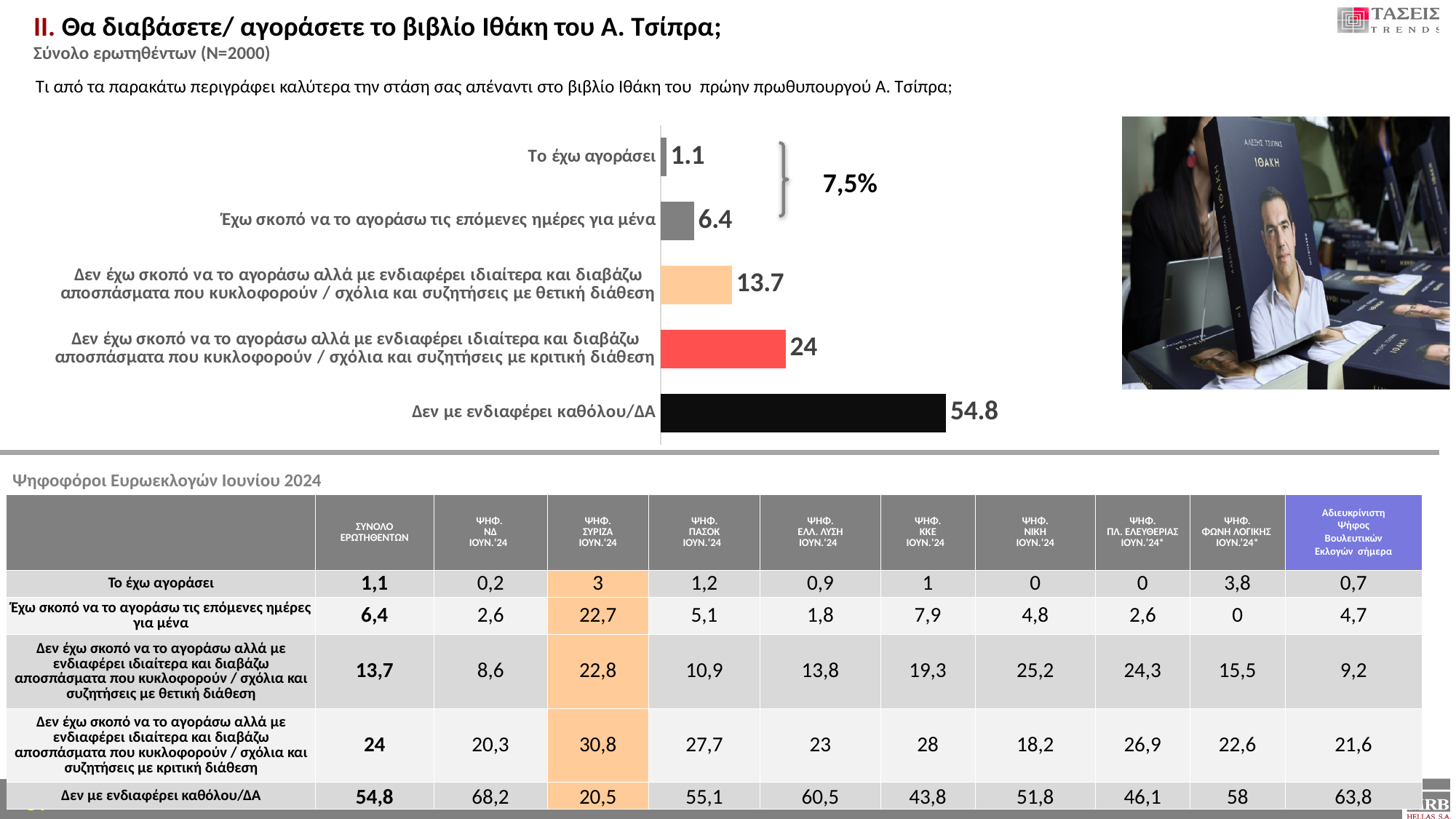
What value is shown for "Δεν με ενδιαφέρει καθόλου/ΔΑ" in the bar chart? 54.8 What value is shown for "Έχω σκοπό να το αγοράσω τις επόμενες ημέρες για μένα" in the bar chart? 6.4 What value is shown for "Το έχω αγοράσει" in the bar chart? 1.1 What kind of chart is shown on the slide? Bar chart How many categories are plotted in the bar chart? 5 Which category has the highest value in the bar chart? Δεν με ενδιαφέρει καθόλου/ΔΑ Which category has the lowest value in the bar chart? Το έχω αγοράσει What is the difference between the value for "Δεν με ενδιαφέρει καθόλου/ΔΑ" and the value for the critical-disposition (κριτική διάθεση) bar? 30.8 What colour is the bar for "Δεν με ενδιαφέρει καθόλου/ΔΑ"? Black What combined percentage does the bracket next to the first two bars show? 7,5% Which is larger: the value for the positive-disposition (θετική διάθεση) bar or the critical-disposition (κριτική διάθεση) bar? κριτική διάθεση (24) What value is shown for the bar about reading excerpts with a critical disposition (κριτική διάθεση)? 24